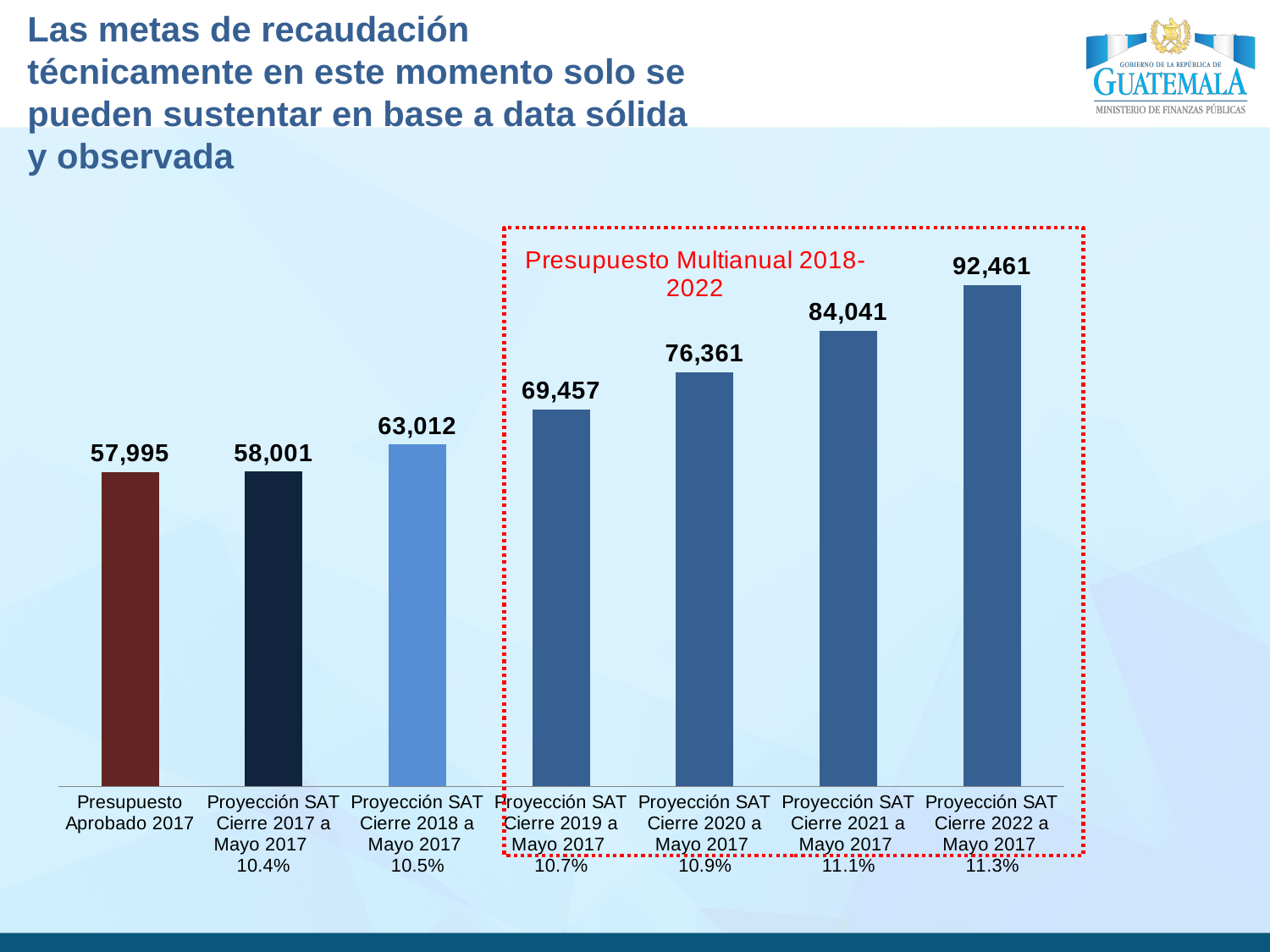
Which category has the lowest value? Presupuesto Aprobado 2017 What is the difference between the values for Proyección SAT Cierre 2021 a Mayo 2017 and Proyección SAT Cierre 2020 a Mayo 2017? 7,680 What is the value for Proyección SAT Cierre 2021 a Mayo 2017? 84,041 Which category has the highest value? Proyección SAT Cierre 2022 a Mayo 2017 What is the value for Presupuesto Aprobado 2017? 57,995 What kind of chart is shown on the slide? Bar chart What is the difference between the values for Proyección SAT Cierre 2022 a Mayo 2017 and Presupuesto Aprobado 2017? 34,466 Do the values rise or fall from left to right across the categories? Rise How many bars are shown in the chart? 7 What is the value for Proyección SAT Cierre 2019 a Mayo 2017? 69,457 Which is larger, the value for Proyección SAT Cierre 2018 a Mayo 2017 or Proyección SAT Cierre 2020 a Mayo 2017? Proyección SAT Cierre 2020 a Mayo 2017 What is the label of the red dotted box enclosing the four rightmost bars? Presupuesto Multianual 2018-2022